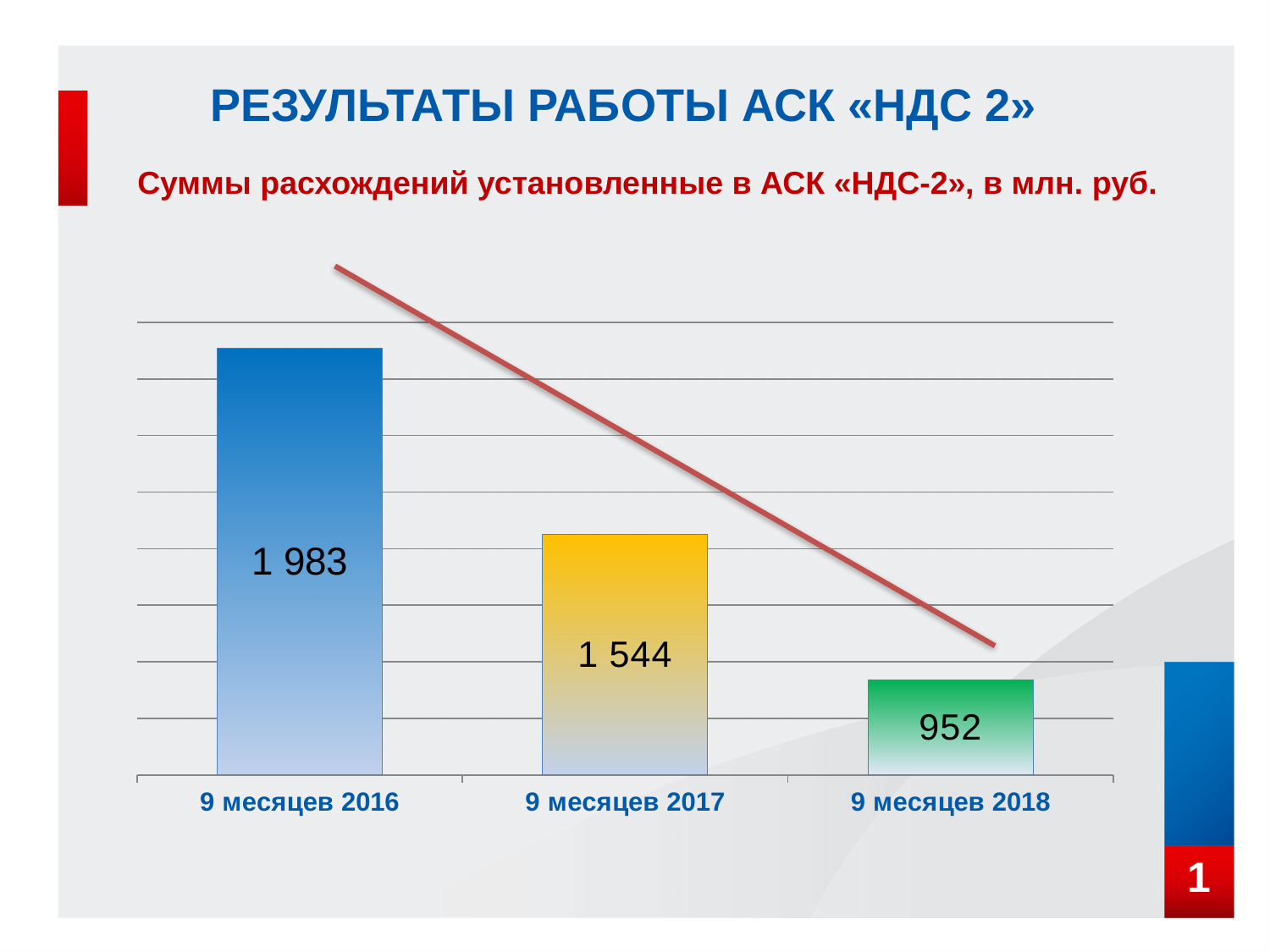
What is the difference between the values for 9 месяцев 2017 and 9 месяцев 2018? 592 What is the difference between the values for 9 месяцев 2016 and 9 месяцев 2018? 1 031 What is the value for 9 месяцев 2017? 1 544 What kind of chart is shown on the slide? Bar chart What is the value for 9 месяцев 2018? 952 What is the difference between the values for 9 месяцев 2016 and 9 месяцев 2017? 439 Which category has the lowest value? 9 месяцев 2018 Which is larger, the value for 9 месяцев 2017 or the value for 9 месяцев 2018? 9 месяцев 2017 Which category has the highest value? 9 месяцев 2016 How many categories are shown on the x axis? 3 Do the values rise or fall from 9 месяцев 2016 to 9 месяцев 2018? Fall What is the value for 9 месяцев 2016? 1 983